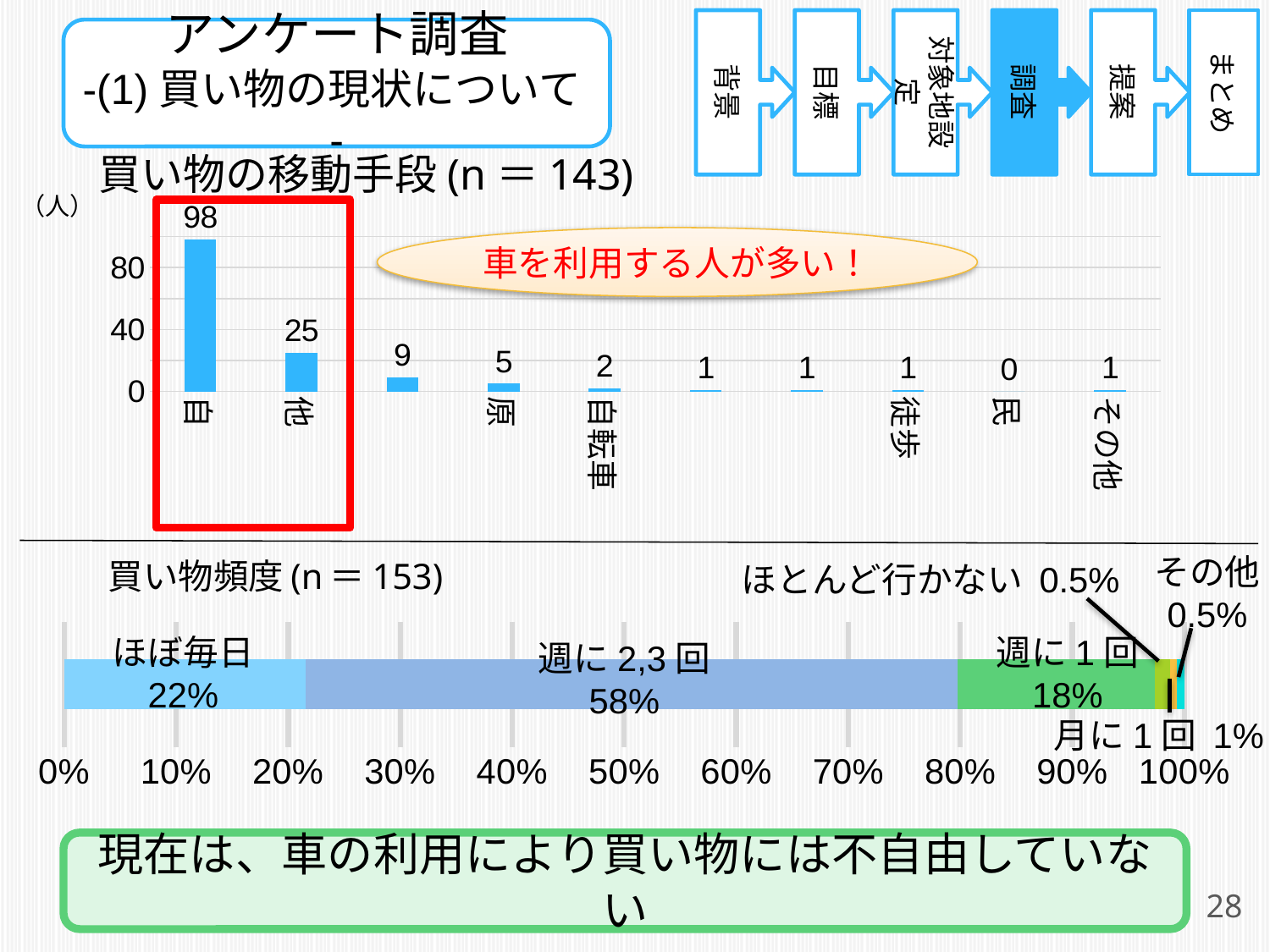
What kind of chart is the top chart 買い物の移動手段? bar chart In the top chart 買い物の移動手段, what is the value for 徒歩? 1 In the bottom chart 買い物頻度, how many segments make up the stacked bar? 6 In the bottom chart 買い物頻度, what is the share for ほぼ毎日? 22% In the top chart 買い物の移動手段, how many bars (categories) are plotted? 10 In the top chart 買い物の移動手段, which is larger, the value for 自転車 or the value for 徒歩? 自転車 In the bottom chart 買い物頻度, what is the share for 週に 2,3 回? 58% In the bottom chart 買い物頻度, what is the difference between the shares for 週に 2,3 回 and 週に 1 回? 40% In the top chart 買い物の移動手段, what is the value for 自転車? 2